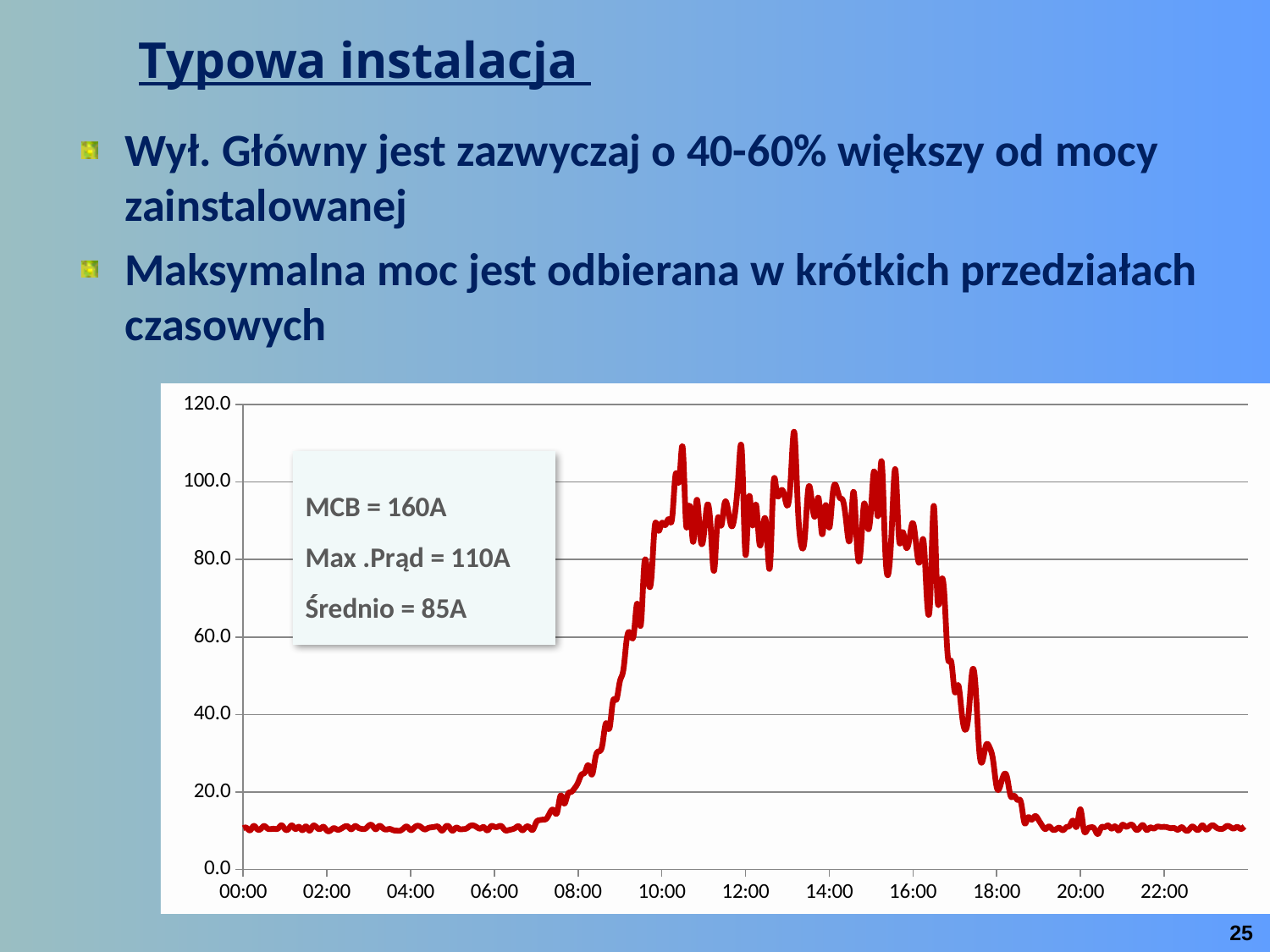
Is the value at 10:00 greater or less than 60.0? greater According to the text box on the chart, what is the maximum current (Max .Prąd)? 110A What kind of chart is shown on the slide? line chart Is the value at 04:00 greater or less than 20.0? less Does the line rise or fall between 16:00 and 18:00? fall What is the highest value shown on the vertical axis of the chart? 120.0 Does the line rise or fall between 06:00 and 10:00? rise Is the value at 22:00 greater or less than 20.0? less According to the text box on the chart, what is the average (Średnio) current? 85A According to the text box on the chart, what is the value of MCB? 160A